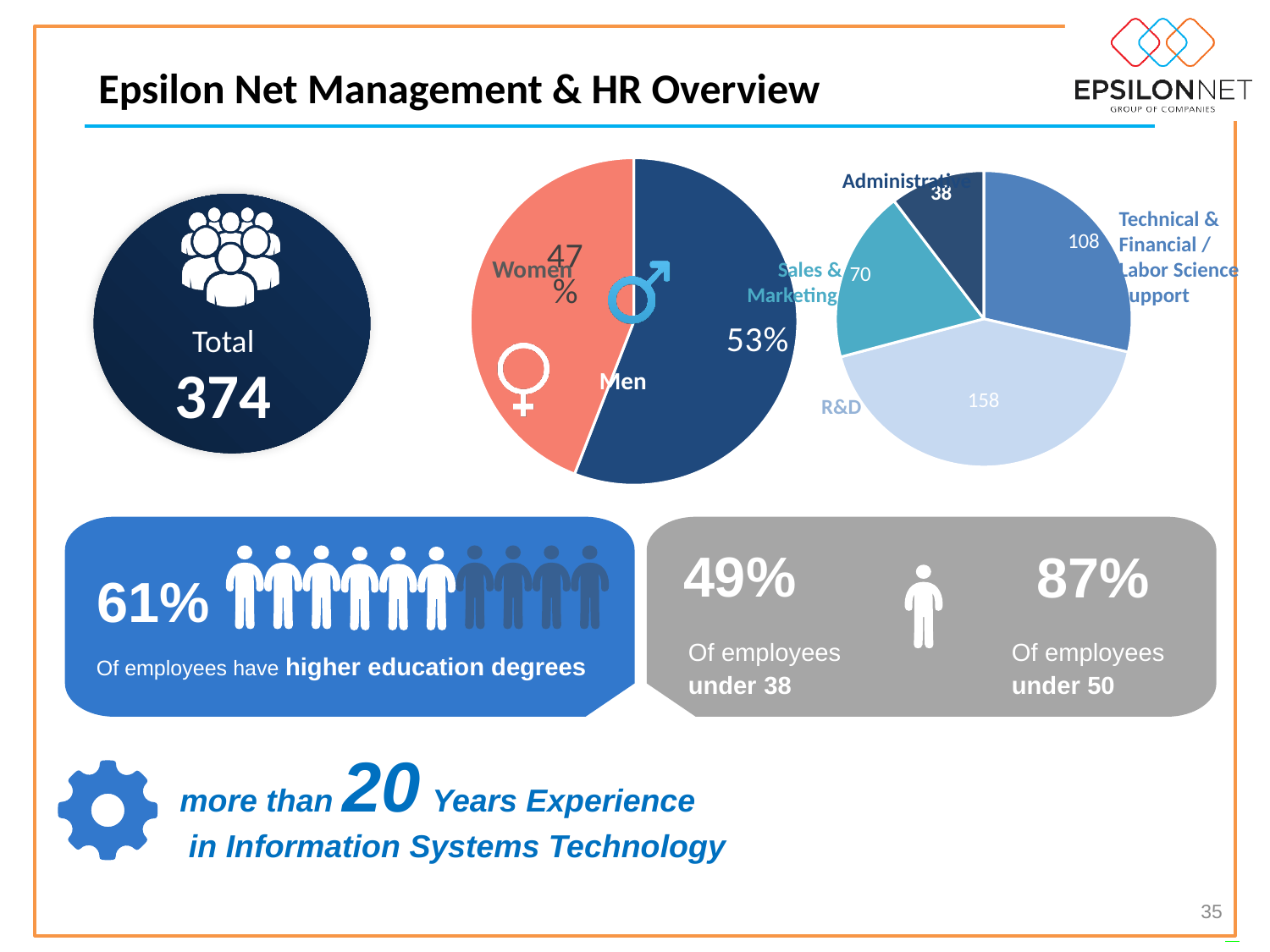
In the gender pie chart (middle of the slide), what percentage is shown for Men? 53% In the department pie chart (right of the slide), what is the value for Sales & Marketing? 70 In the department pie chart (right of the slide), which department has the smallest slice? Administrative In the department pie chart (right of the slide), what is the value for Technical & Financial / Labor Science Support? 108 In the department pie chart (right of the slide), what is the value for Administrative? 38 In the department pie chart (right of the slide), how much larger is R&D than Technical & Financial / Labor Science Support? 50 How many slices does the department pie chart on the right of the slide have? 4 In the department pie chart (right of the slide), what is the value for R&D? 158 In the department pie chart (right of the slide), which department has the largest slice? R&D In the gender pie chart (middle of the slide), which slice is larger, Men or Women? Men In the gender pie chart (middle of the slide), what percentage is shown for Women? 47% What kind of chart is the gender chart in the middle of the slide? Pie chart